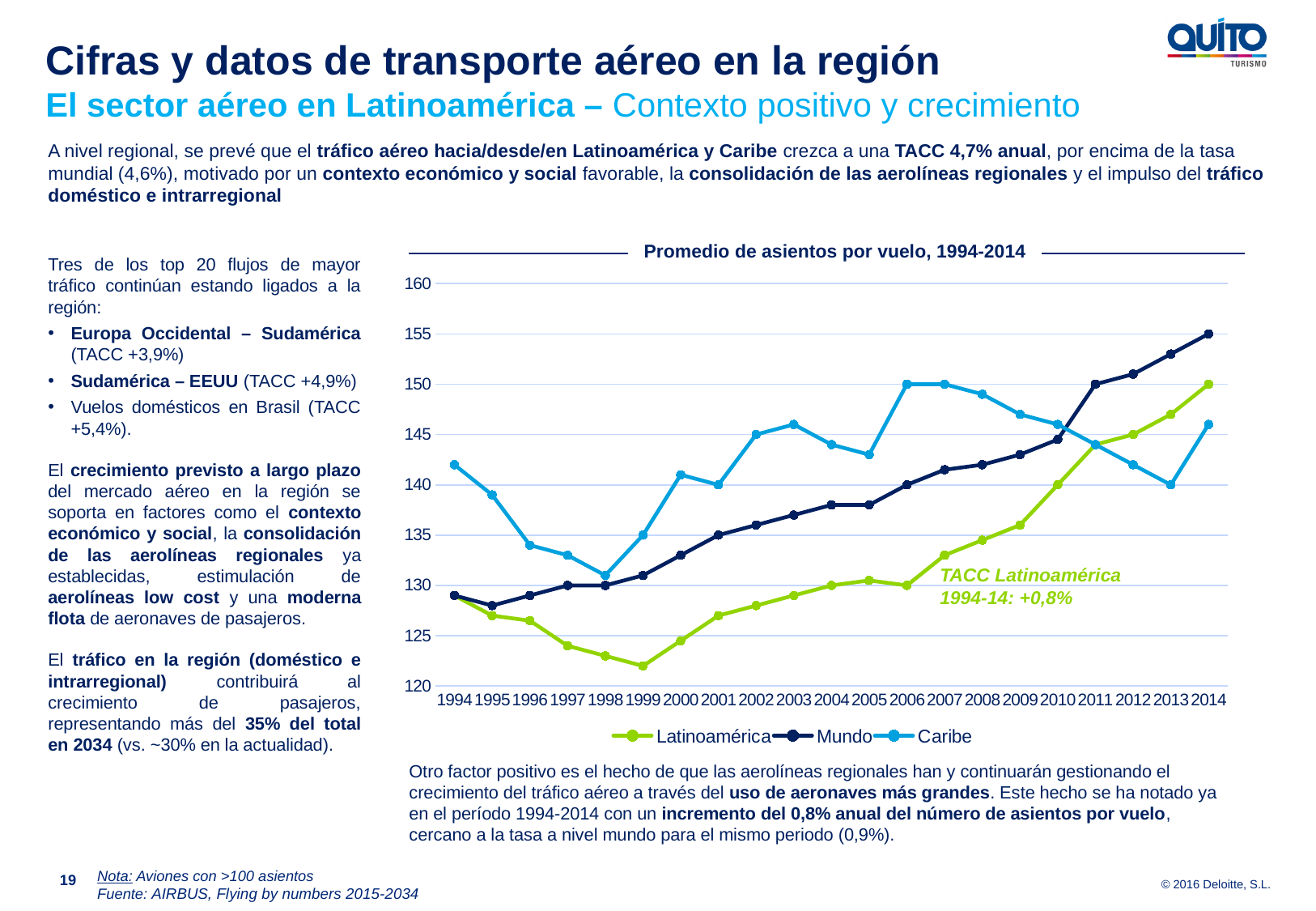
What kind of chart is shown on the slide? line chart How many series does the chart legend list? 3 Does the Mundo series generally rise or fall from 1994 to 2014? rise What is the value for Mundo in 2014? 155 In 1994, which series has the higher value, Caribe or Latinoamérica? Caribe What is the value for Latinoamérica in 2014? 150 What is the title of the chart? Promedio de asientos por vuelo, 1994-2014 Is the value for Latinoamérica in 1999 greater or less than 125? less In which year is the Mundo series at its highest? 2014 Is the value for Mundo in 2013 greater or less than 150? greater In which year is the Latinoamérica series at its lowest? 1999 How many years are plotted along the x axis of the chart? 21